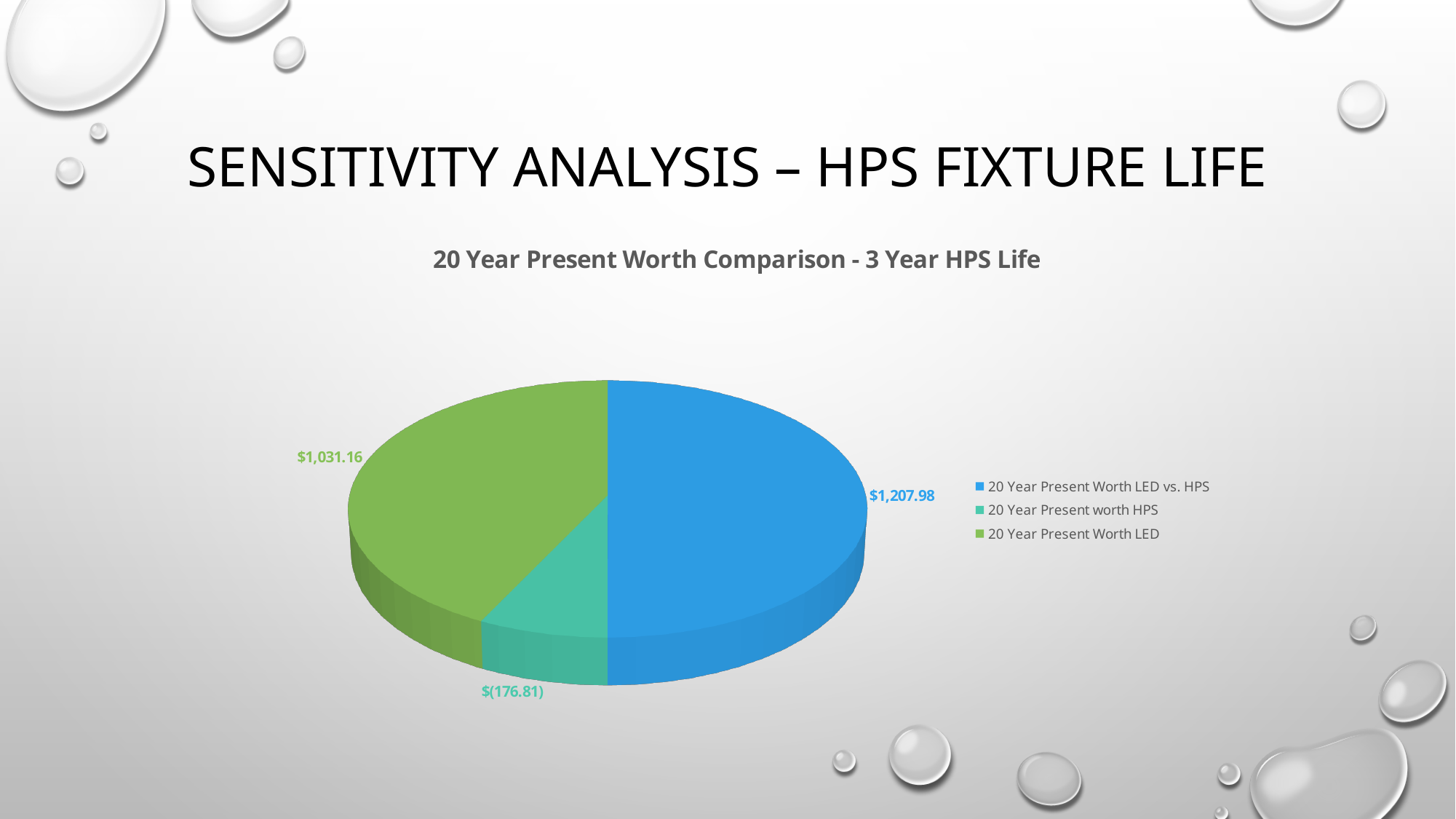
What kind of chart is shown on the slide? Pie chart What colour is the 20 Year Present Worth LED slice? Green Which category has the largest slice in the pie chart? 20 Year Present Worth LED vs. HPS Which is larger, the 20 Year Present Worth LED vs. HPS value or the 20 Year Present Worth LED value? 20 Year Present Worth LED vs. HPS How many entries does the legend list? 3 What is the title of the chart? 20 Year Present Worth Comparison - 3 Year HPS Life What is the value shown for the 20 Year Present Worth LED vs. HPS slice? $1,207.98 Which category has the smallest slice in the pie chart? 20 Year Present worth HPS How many slices does the pie chart have? 3 What is the value shown for the 20 Year Present worth HPS slice? $(176.81) What is the value shown for the 20 Year Present Worth LED slice? $1,031.16 What is the difference between the 20 Year Present Worth LED vs. HPS value and the 20 Year Present Worth LED value? $176.82